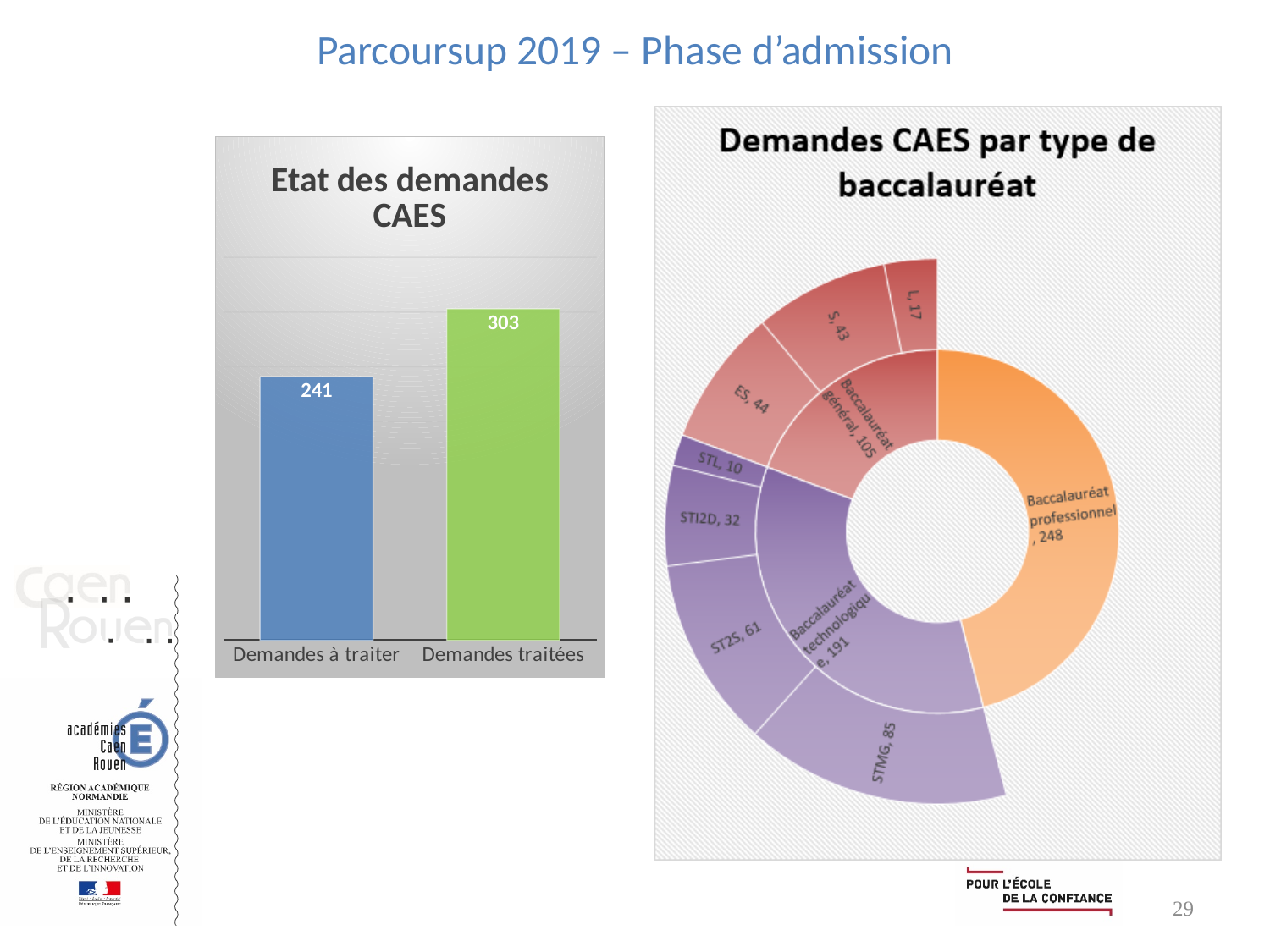
In the chart 'Etat des demandes CAES', what is the value for 'Demandes traitées'? 303 In the chart 'Demandes CAES par type de baccalauréat', what is the value for 'Baccalauréat professionnel'? 248 In the chart 'Etat des demandes CAES', what is the value for 'Demandes à traiter'? 241 In the chart 'Etat des demandes CAES', what is the difference between 'Demandes traitées' and 'Demandes à traiter'? 62 How many categories are shown in the chart 'Etat des demandes CAES'? 2 What kind of chart is 'Etat des demandes CAES'? Bar chart In the chart 'Demandes CAES par type de baccalauréat', what is the difference between 'Baccalauréat professionnel' and 'Baccalauréat technologique'? 57 In the chart 'Demandes CAES par type de baccalauréat', what is the value for 'STMG'? 85 In the chart 'Demandes CAES par type de baccalauréat', which type of baccalauréat in the inner ring has the lowest value? Baccalauréat général In the chart 'Etat des demandes CAES', which category has the higher value? Demandes traitées In the chart 'Demandes CAES par type de baccalauréat', which is larger, 'ST2S' or 'STI2D'? ST2S In the chart 'Demandes CAES par type de baccalauréat', what is the value for 'Baccalauréat technologique'? 191